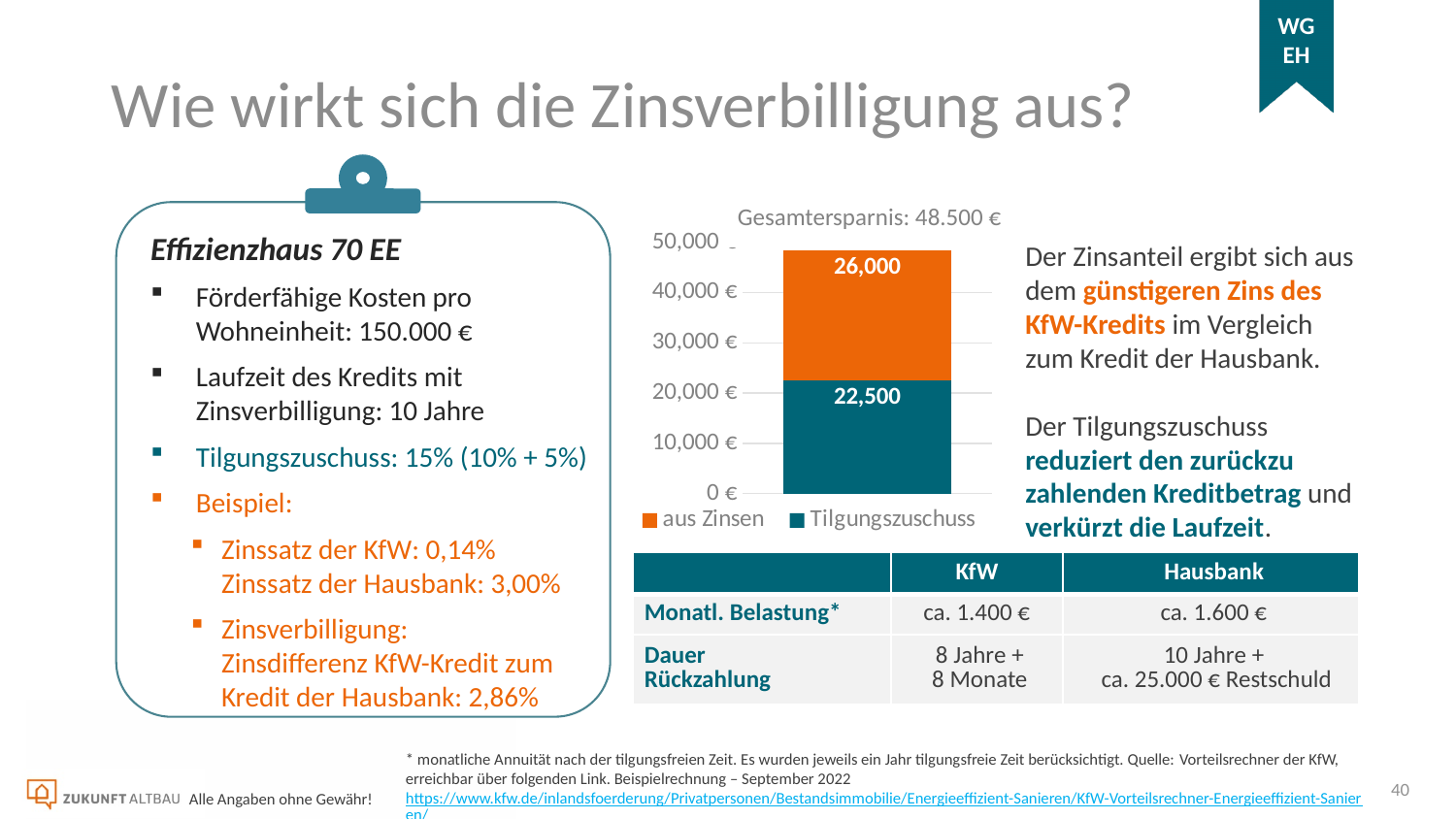
What is the difference between the "aus Zinsen" value and the "Tilgungszuschuss" value in the chart? 3,500 What kind of chart is shown on the slide? Stacked bar chart What is the title of the chart? Gesamtersparnis: 48.500 € Which segment of the stacked bar is larger, "aus Zinsen" or "Tilgungszuschuss"? aus Zinsen Is the value of the "Tilgungszuschuss" segment greater or less than 20,000 €? greater Is the value of the "aus Zinsen" segment greater or less than 30,000 €? less What is the value of the "Tilgungszuschuss" segment in the chart? 22,500 How many bars are plotted in the chart? 1 How many series does the chart legend list? 2 What is the value of the "aus Zinsen" segment in the chart? 26,000 What is the total of the stacked bar in the chart? 48,500 Which colour represents the "Tilgungszuschuss" series in the chart? Teal